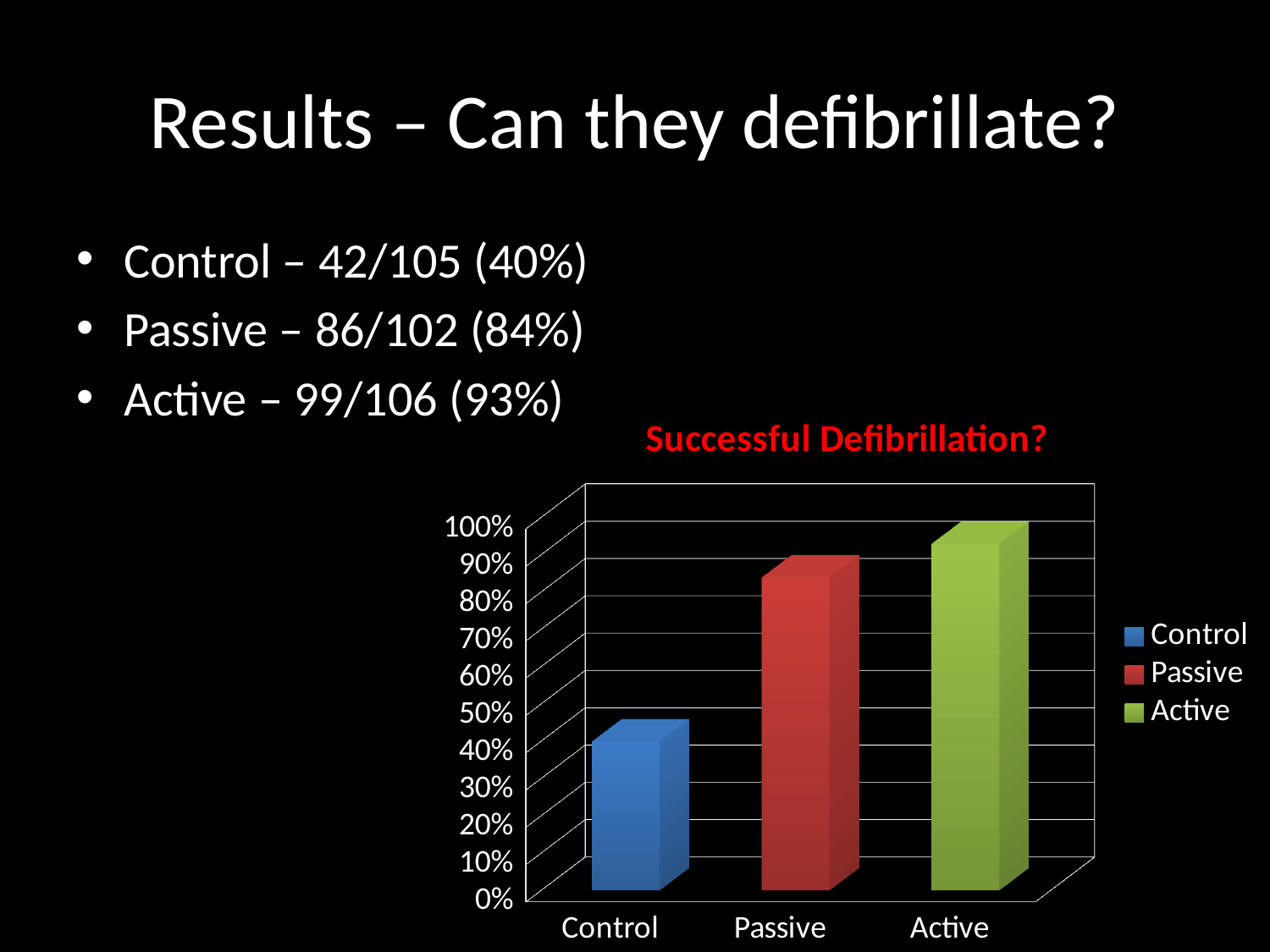
What colour is the bar for Passive in the chart? red Is the value for Active greater or less than 90%? greater How many entries does the chart's legend list? 3 Which category has the highest successful defibrillation rate in the chart? Active What is the title of the chart? Successful Defibrillation? How many categories are shown on the x axis of the chart? 3 Do the values rise or fall moving from Control to Active along the x axis? rise Is the value for Passive greater or less than 80%? greater Which category has the lowest successful defibrillation rate in the chart? Control What type of chart is shown on the slide? bar chart Is the value for Control greater or less than 50%? less Which is larger, the value for Passive or the value for Control? Passive